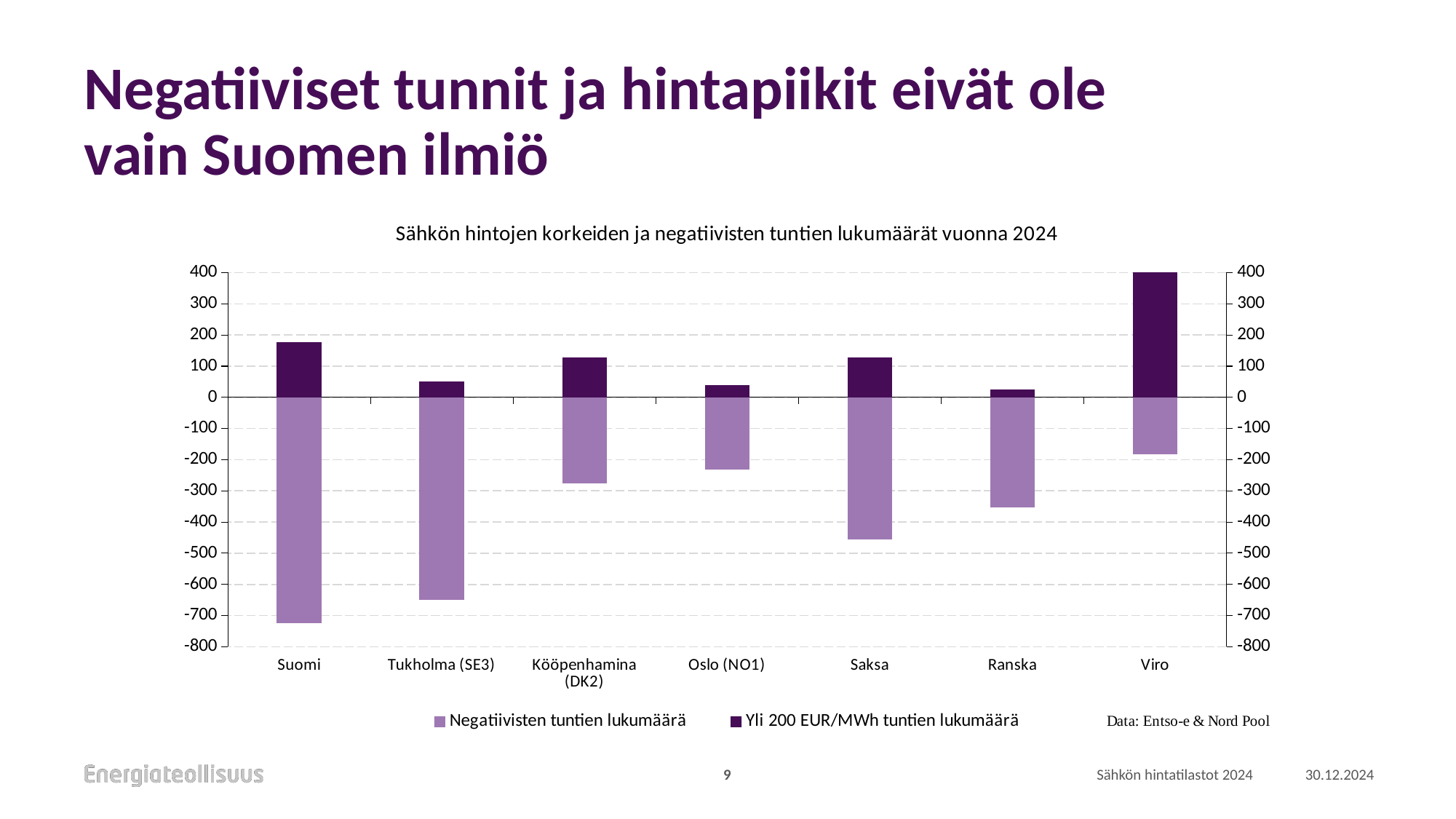
Which category has the largest number of negative hours (the longest bar below zero)? Suomi Which category has the smallest number of negative hours (the shortest bar below zero)? Viro What is the title of the chart? Sähkön hintojen korkeiden ja negatiivisten tuntien lukumäärät vuonna 2024 How many series does the legend list? 2 Is the value for Suomi in the 'Negatiivisten tuntien lukumäärä' series greater or less than -700? less Which has more negative hours, Saksa or Ranska? Saksa Is the value for Suomi in the 'Yli 200 EUR/MWh tuntien lukumäärä' series greater or less than 100? greater Is the value for Oslo (NO1) in the 'Yli 200 EUR/MWh tuntien lukumäärä' series greater or less than 100? less What type of chart is shown on the slide? bar chart How many categories (countries/price areas) are shown on the x axis? 7 Which category has the highest value for 'Yli 200 EUR/MWh tuntien lukumäärä'? Viro